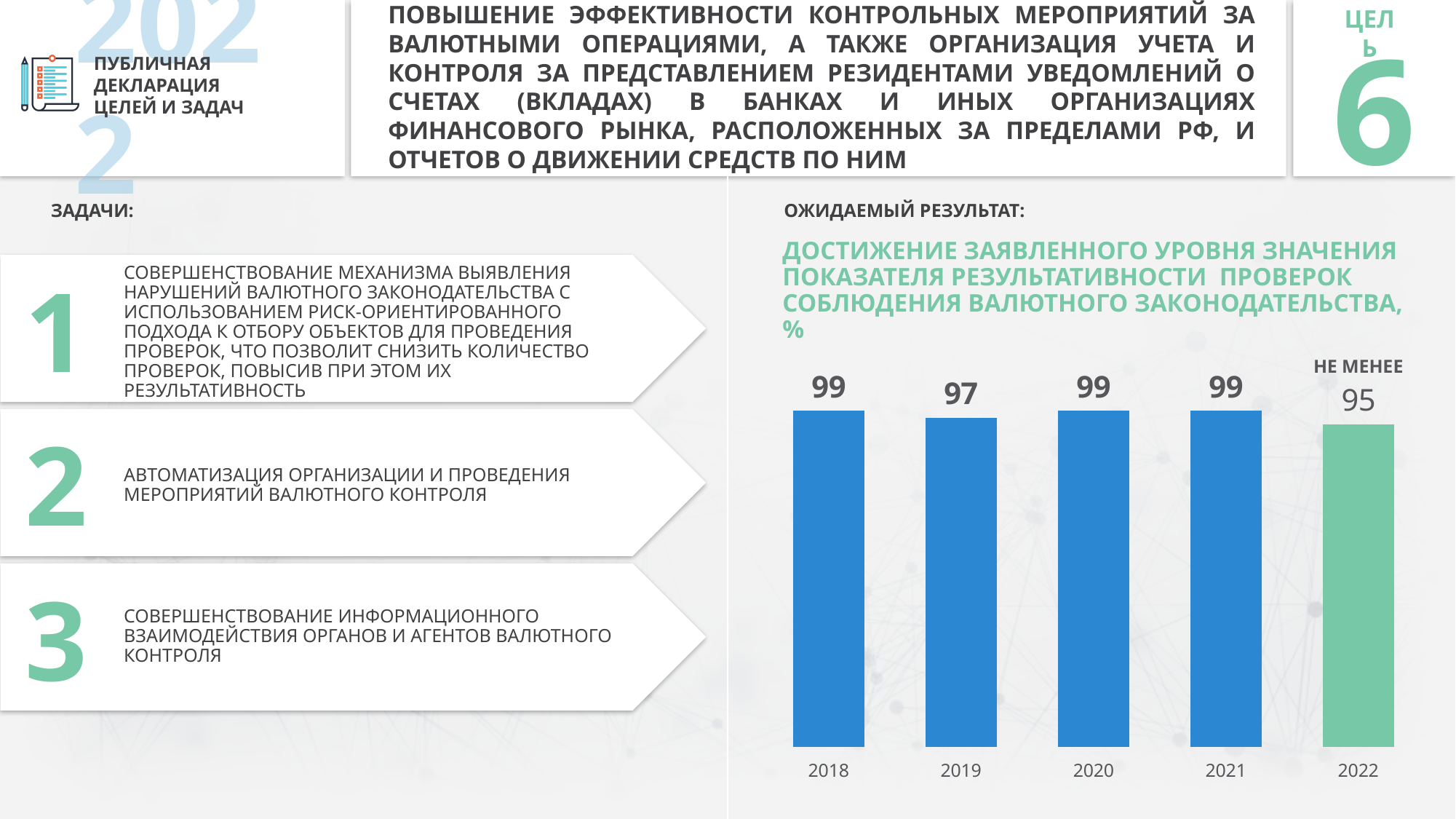
What is the value shown for 2021? 99 Which year has the lowest value in the chart? 2022 What text is printed above the value for the 2022 bar? НЕ МЕНЕЕ What is the value shown for 2022? 95 What kind of chart is shown on the slide? bar chart Which is larger, the value for 2019 or the value for 2022? 2019 What is the value shown for 2019? 97 What is the value shown for 2018? 99 What is the difference between the values for 2018 and 2019? 2 How many years are shown on the x axis of the chart? 5 Does the value rise or fall from 2021 to 2022? fall What is the difference between the values for 2019 and 2022? 2